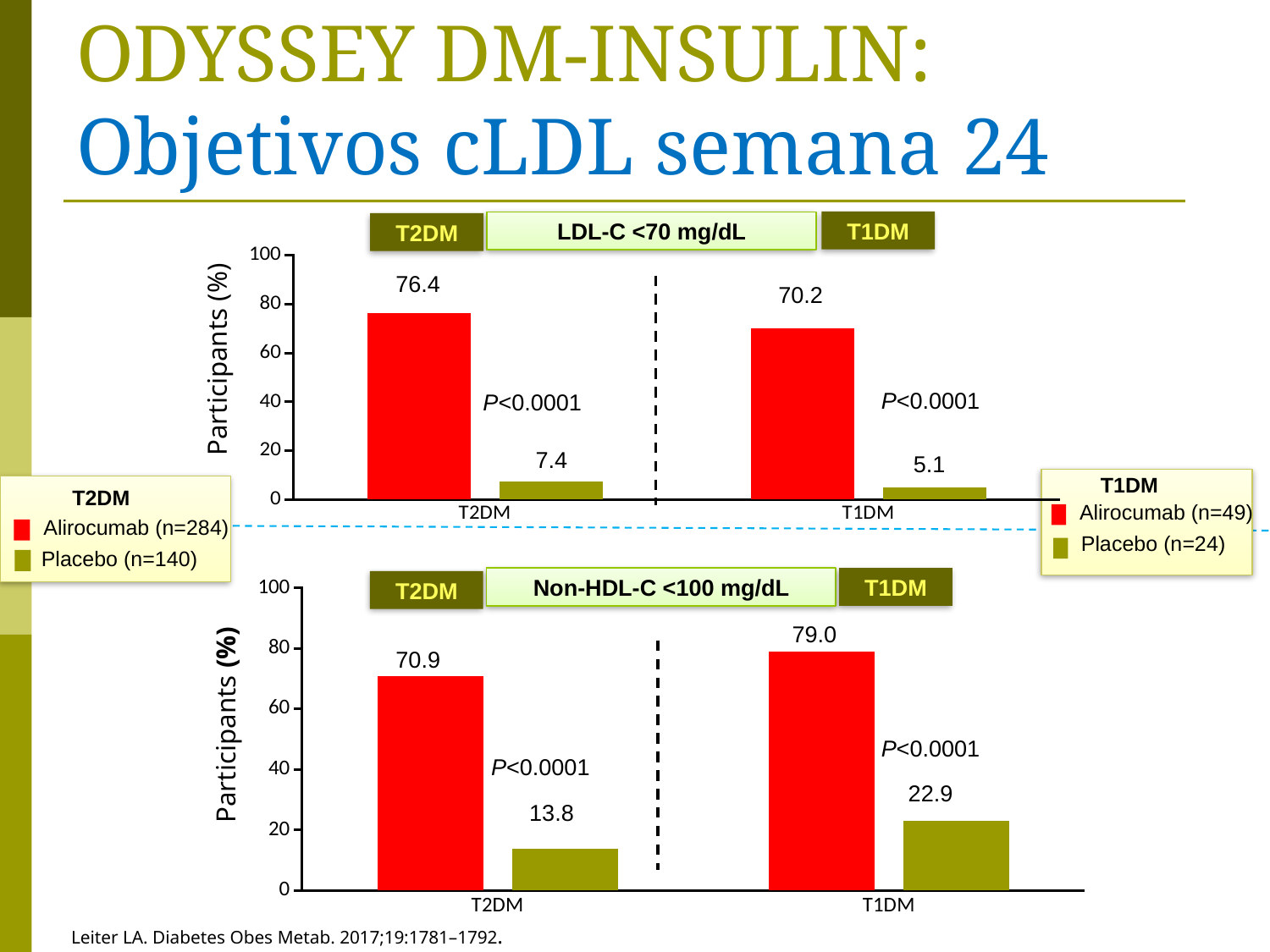
In the LDL-C <70 mg/dL chart, which bar is the lowest? Placebo in T1DM (5.1) In the LDL-C <70 mg/dL chart, what is the difference between Alirocumab and Placebo in the T2DM group? 69.0 In the Non-HDL-C <100 mg/dL chart, is the Placebo value larger in the T2DM group or the T1DM group? T1DM According to the T2DM legend, how many participants were in the Placebo group? 140 In the Non-HDL-C <100 mg/dL chart, what is the value for Placebo in the T2DM group? 13.8 In the Non-HDL-C <100 mg/dL chart, what is the value for Alirocumab in the T1DM group? 79.0 In the Non-HDL-C <100 mg/dL chart, which bar is the highest? Alirocumab in T1DM (79.0) What type of chart is used on this slide? Bar chart In the LDL-C <70 mg/dL chart, is the Alirocumab value for T1DM greater or less than 60? greater In the LDL-C <70 mg/dL chart, what is the value for Placebo in the T1DM group? 5.1 In the Non-HDL-C <100 mg/dL chart, what is the difference between Alirocumab and Placebo in the T1DM group? 56.1 In the LDL-C <70 mg/dL chart, what percentage of T2DM participants on Alirocumab reached the goal? 76.4